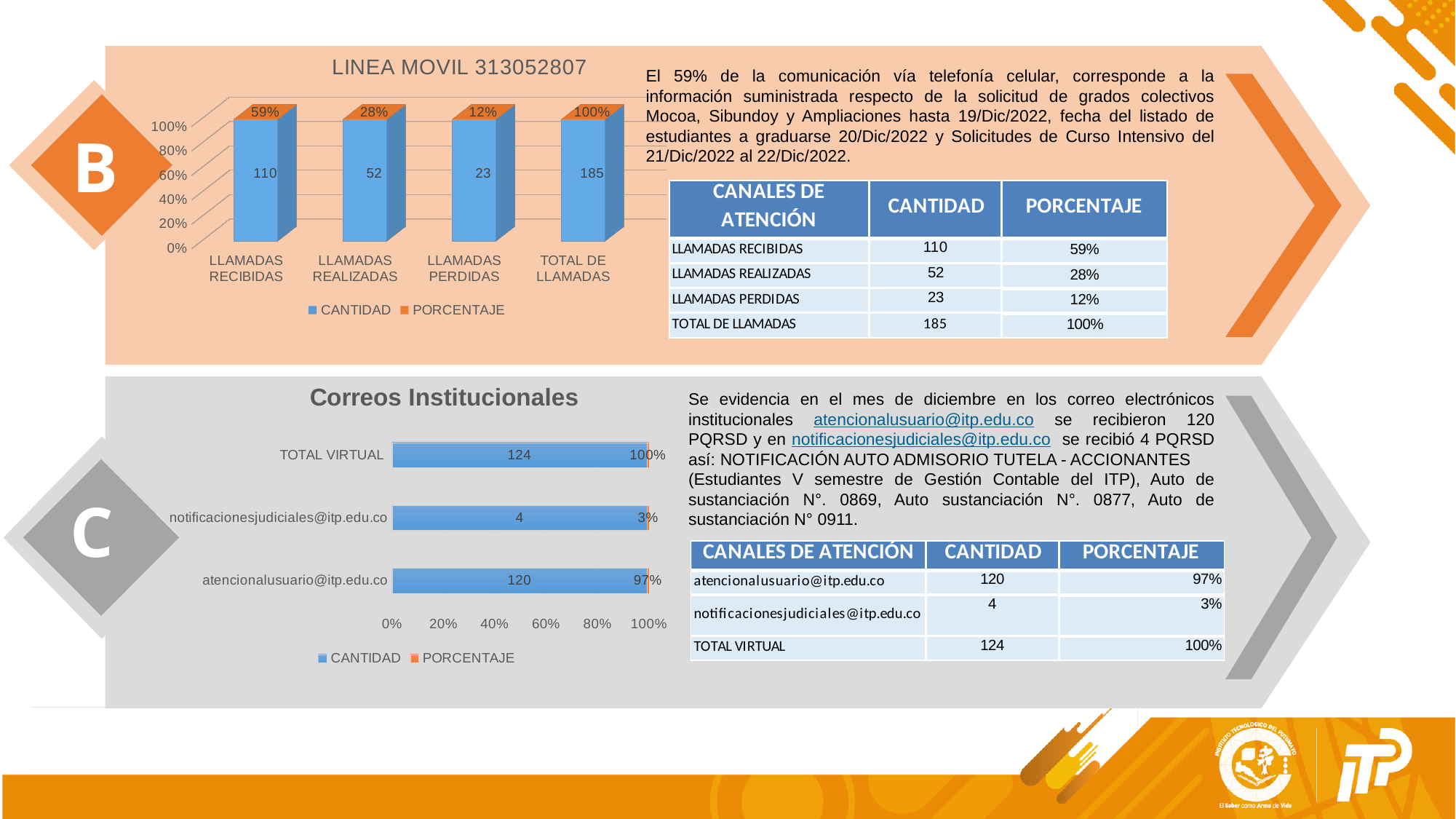
In the 'LINEA MOVIL 313052807' chart, what PORCENTAJE is shown for LLAMADAS REALIZADAS? 28% What type of chart is 'Correos Institucionales'? Bar chart In the 'LINEA MOVIL 313052807' chart, how many categories are shown on the x axis? 4 In the 'Correos Institucionales' chart, what is the difference between the CANTIDAD for TOTAL VIRTUAL and atencionalusuario@itp.edu.co? 4 In the 'LINEA MOVIL 313052807' chart, what is the CANTIDAD value for LLAMADAS RECIBIDAS? 110 In the 'LINEA MOVIL 313052807' chart, how many series does the legend list? 2 In the 'Correos Institucionales' chart, what PORCENTAJE is shown for atencionalusuario@itp.edu.co? 97% What is the title of the chart in the top section of the slide? LINEA MOVIL 313052807 In the 'LINEA MOVIL 313052807' chart, what is the difference between the CANTIDAD for LLAMADAS RECIBIDAS and LLAMADAS REALIZADAS? 58 In the 'Correos Institucionales' chart, which of the two email addresses has the larger CANTIDAD value? atencionalusuario@itp.edu.co In the 'Correos Institucionales' chart, what is the CANTIDAD value for notificacionesjudiciales@itp.edu.co? 4 In the 'LINEA MOVIL 313052807' chart, which category has the lowest CANTIDAD value? LLAMADAS PERDIDAS